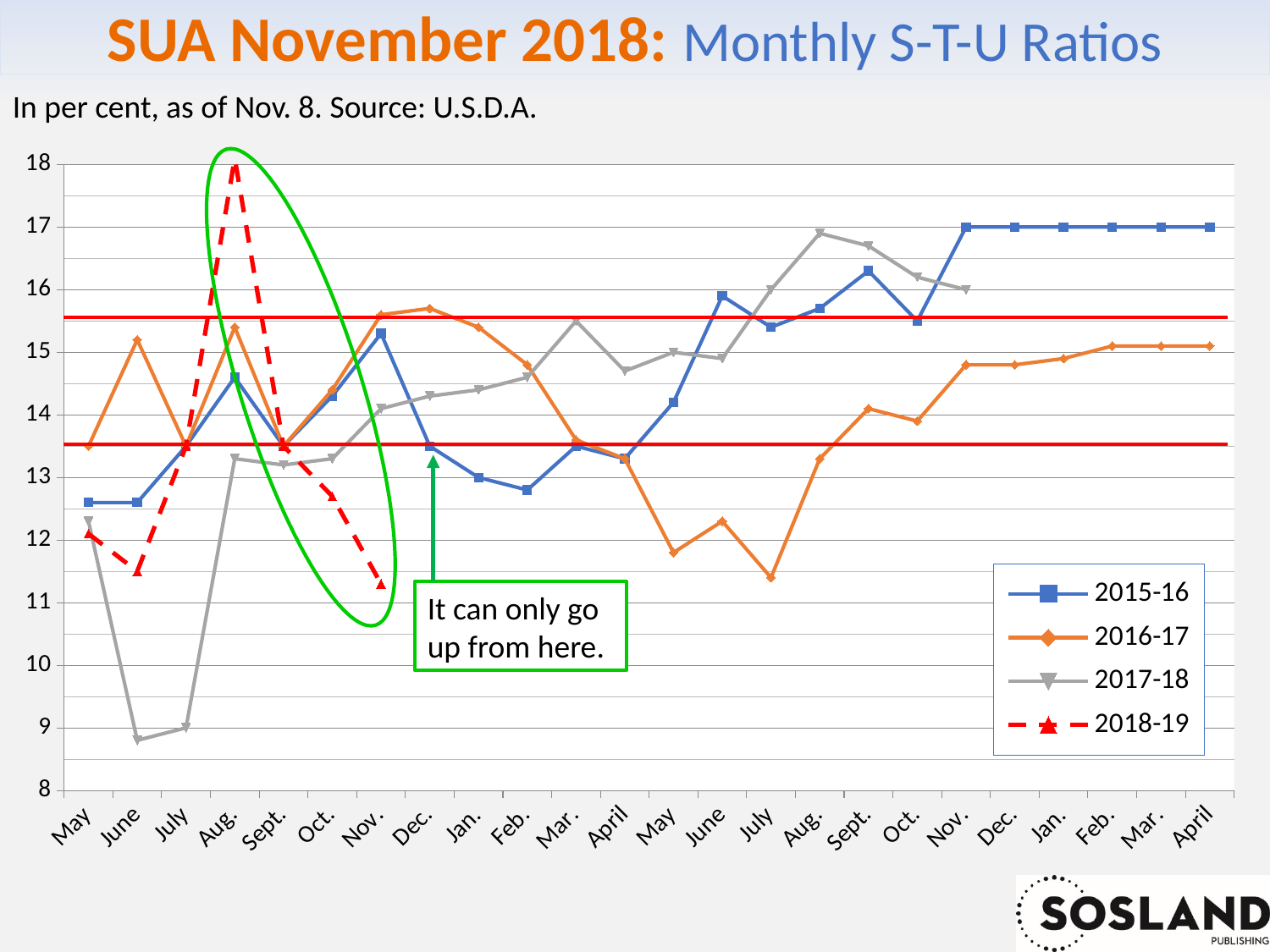
Which series has the lowest value on the chart? 2017-18 What kind of chart is shown on the slide? line chart How many month labels are there along the x axis? 24 Is the value for 2017-18 in the first June greater or less than 10? less In the second Dec., which series has the larger value, 2015-16 or 2016-17? 2015-16 Which series reaches the highest value on the chart? 2018-19 How many series does the legend list? 4 Is the value for 2018-19 in the first Aug. greater or less than 17? greater Which series is drawn as a red dashed line? 2018-19 Is the value for 2016-17 in the second July greater or less than 12? less Does the 2018-19 series rise or fall from the first Aug. to the first Nov.? fall